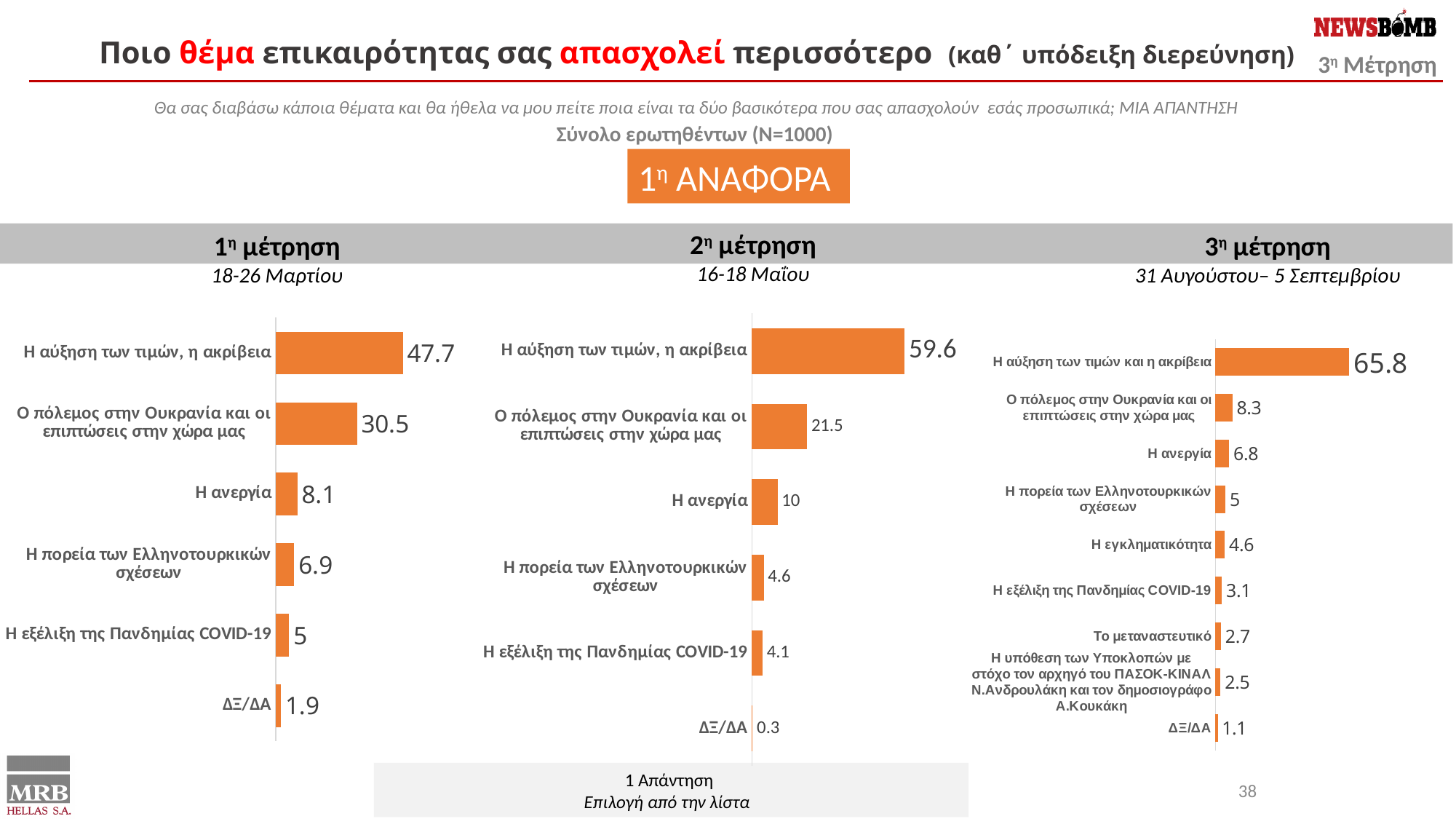
What kind of chart is the 2η μέτρηση chart? bar chart How many categories are shown in the 3η μέτρηση chart? 9 How many categories are shown in the 1η μέτρηση chart? 6 In the 1η μέτρηση chart, what is the difference between Η αύξηση των τιμών, η ακρίβεια and Ο πόλεμος στην Ουκρανία και οι επιπτώσεις στην χώρα μας? 17.2 In the 2η μέτρηση chart, what is the difference between Η πορεία των Ελληνοτουρκικών σχέσεων and Η εξέλιξη της Πανδημίας COVID-19? 0.5 In the 2η μέτρηση chart, what is the value for Η ανεργία? 10 In the 1η μέτρηση chart, what is the value for Η αύξηση των τιμών, η ακρίβεια? 47.7 What date range is shown under the 3η μέτρηση chart? 31 Αυγούστου– 5 Σεπτεμβρίου In the 3η μέτρηση chart, what is the value for Το μεταναστευτικό? 2.7 In the 3η μέτρηση chart, which is larger: Η ανεργία or Η εγκληματικότητα? Η ανεργία In the 3η μέτρηση chart, which category has the highest value? Η αύξηση των τιμών και η ακρίβεια In the 2η μέτρηση chart, which category has the lowest value? ΔΞ/ΔΑ